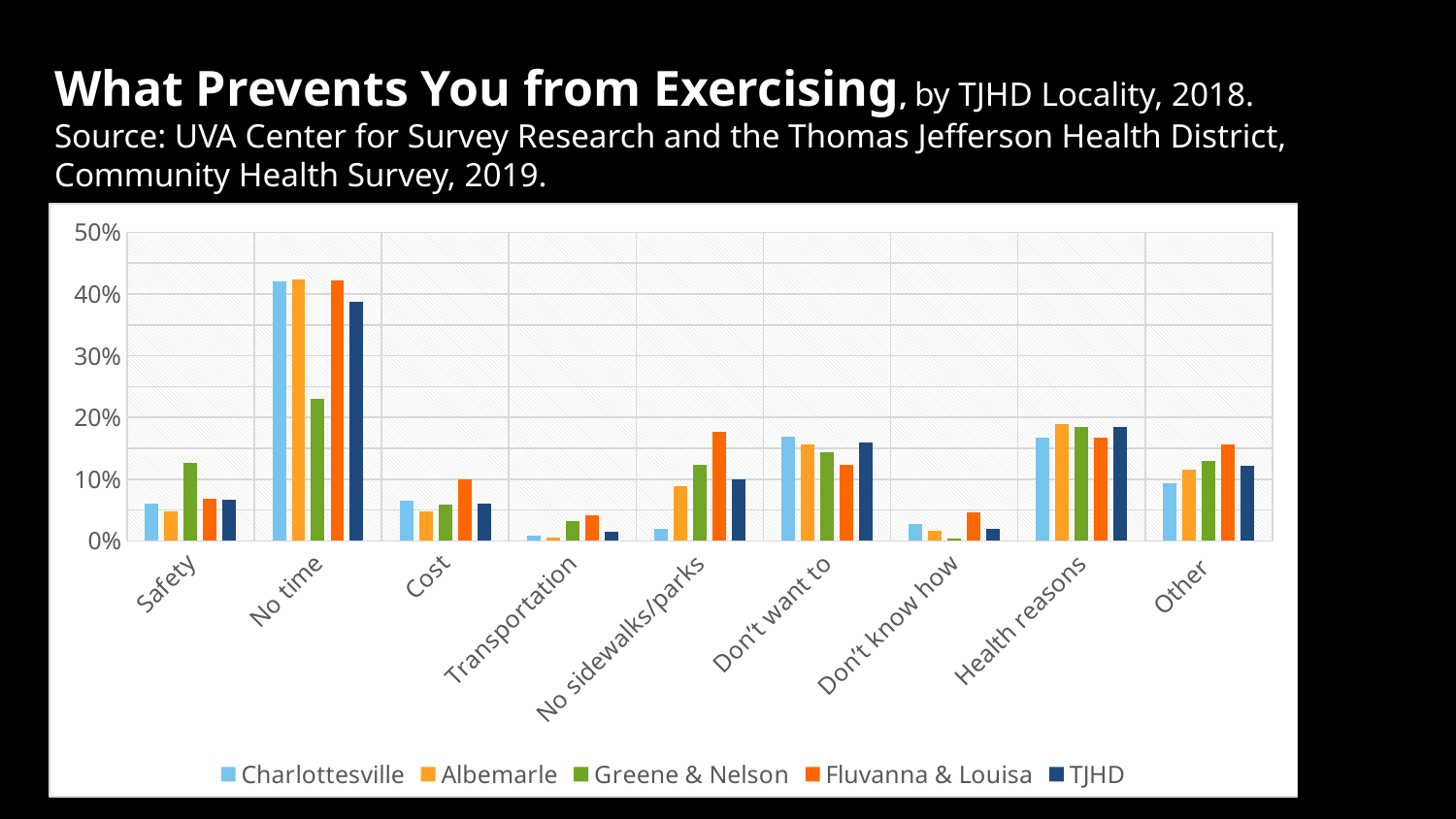
How many series does the legend list? 5 How many categories (reasons) are shown on the x axis? 9 Which reason has the highest value for every locality? No time Is the Fluvanna & Louisa value for No sidewalks/parks greater or less than 10%? greater Within the Safety category, which locality has the highest bar? Greene & Nelson Is the Charlottesville value for Cost greater or less than 10%? less Which locality is shown in the darkest blue bars according to the legend? TJHD Within the No sidewalks/parks category, which locality has the highest bar? Fluvanna & Louisa For No time, which is larger: the Albemarle value or the Greene & Nelson value? Albemarle Is the Greene & Nelson value for No time greater or less than 20%? greater What kind of chart is shown on the slide? bar chart For Greene & Nelson, which reason has the lowest value? Don't know how